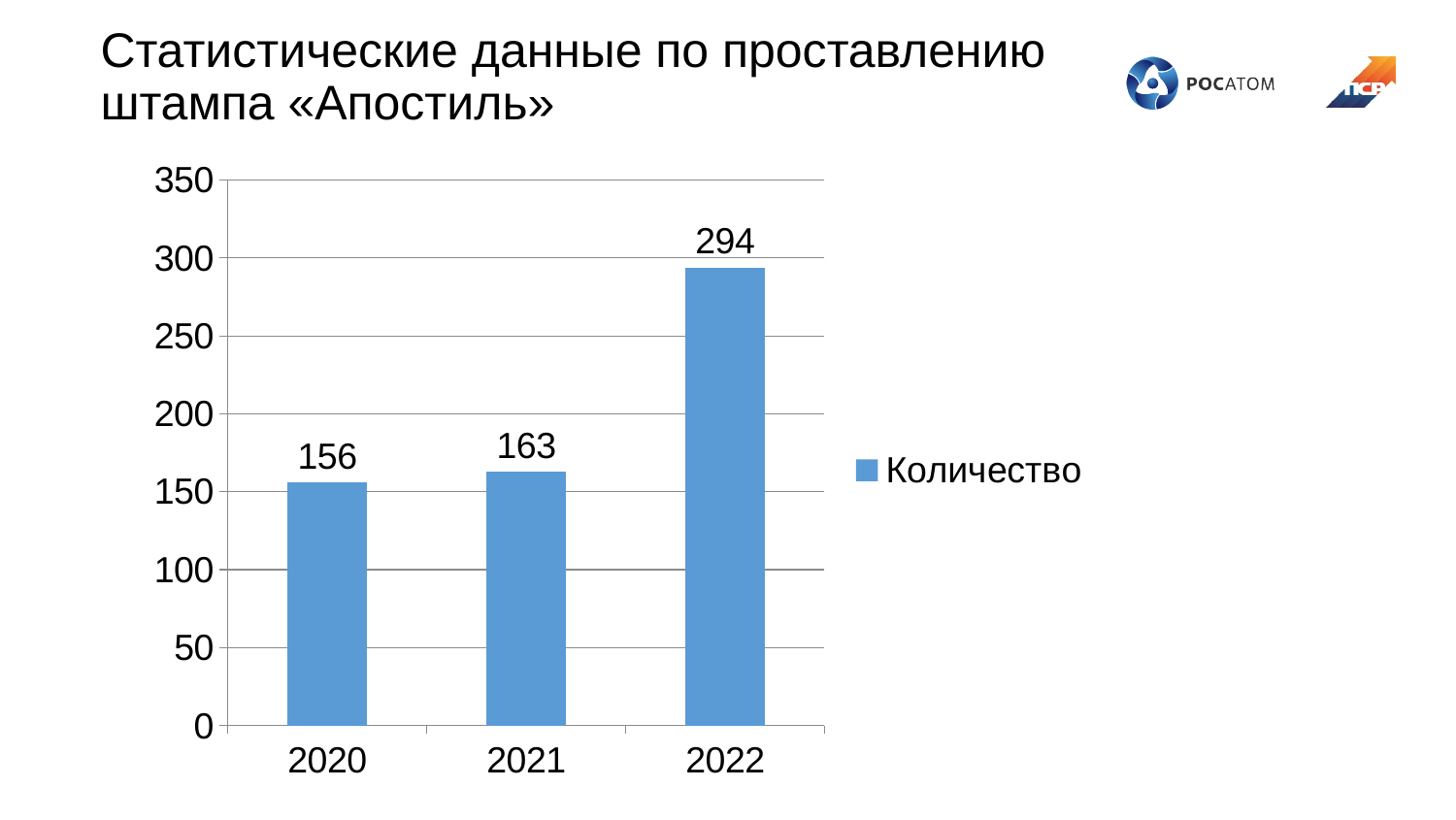
How many years are shown on the x axis? 3 Is the value for 2022 greater or less than 250? greater What is the value for 2022? 294 What kind of chart is shown on the slide? bar chart Which year has the lowest value? 2020 Do the values rise or fall from 2020 to 2022? rise What is the difference between the values for 2022 and 2021? 131 What is the value for 2020? 156 What is the difference between the values for 2021 and 2020? 7 Which is larger, the value for 2022 or the value for 2020? 2022 What is the value for 2021? 163 Which year has the highest value? 2022